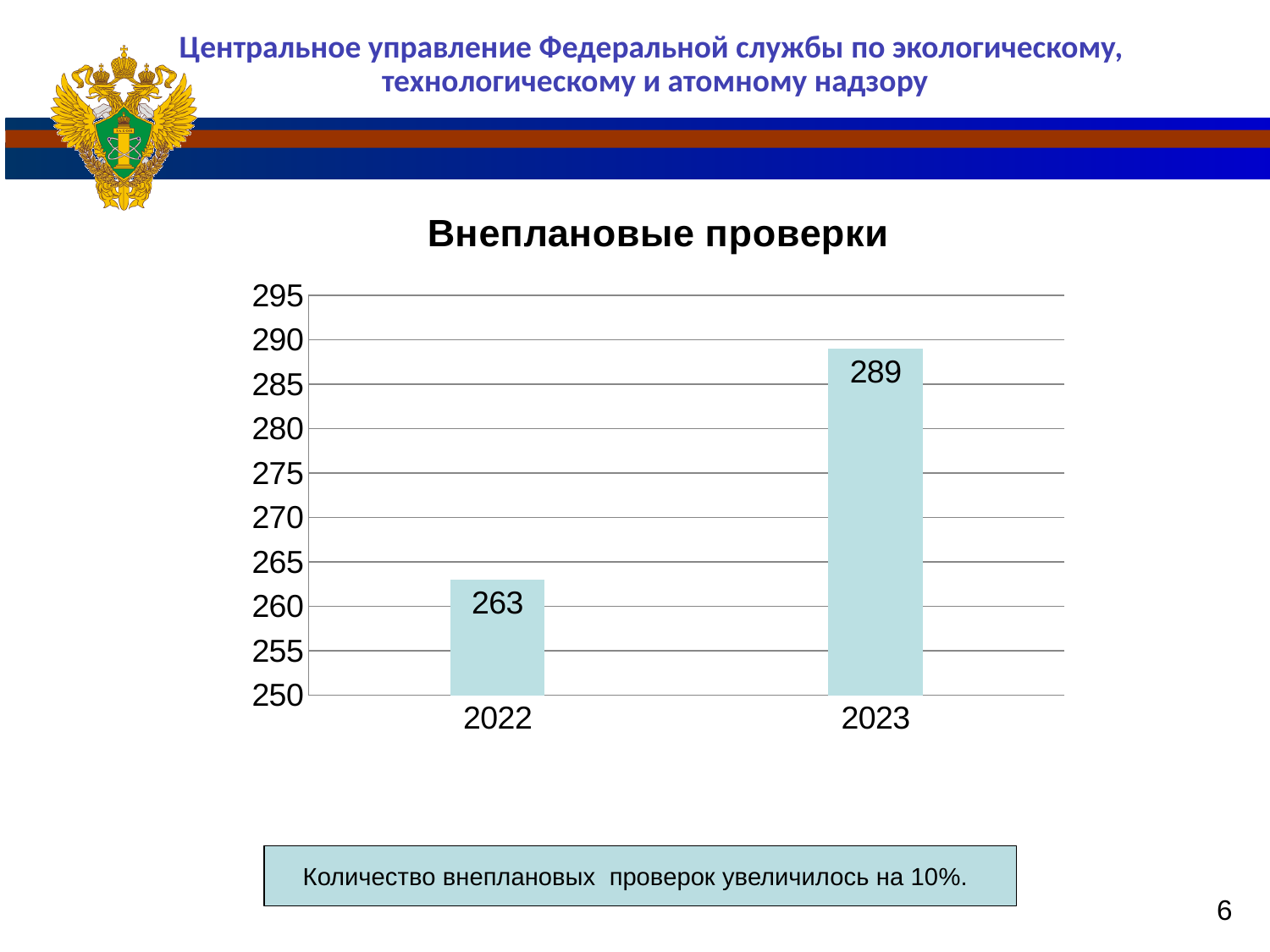
Which is larger, the value for 2022 or the value for 2023? 2023 Do the values rise or fall from 2022 to 2023? rise Which year has the highest value? 2023 What is the title of the chart? Внеплановые проверки What is the value for 2023? 289 Is the value for 2023 greater or less than 280? greater What is the difference between the values for 2023 and 2022? 26 What is the value for 2022? 263 How many categories are shown on the x axis? 2 Is the value for 2022 greater or less than 270? less What kind of chart is shown on the slide? bar chart Which year has the lowest value? 2022